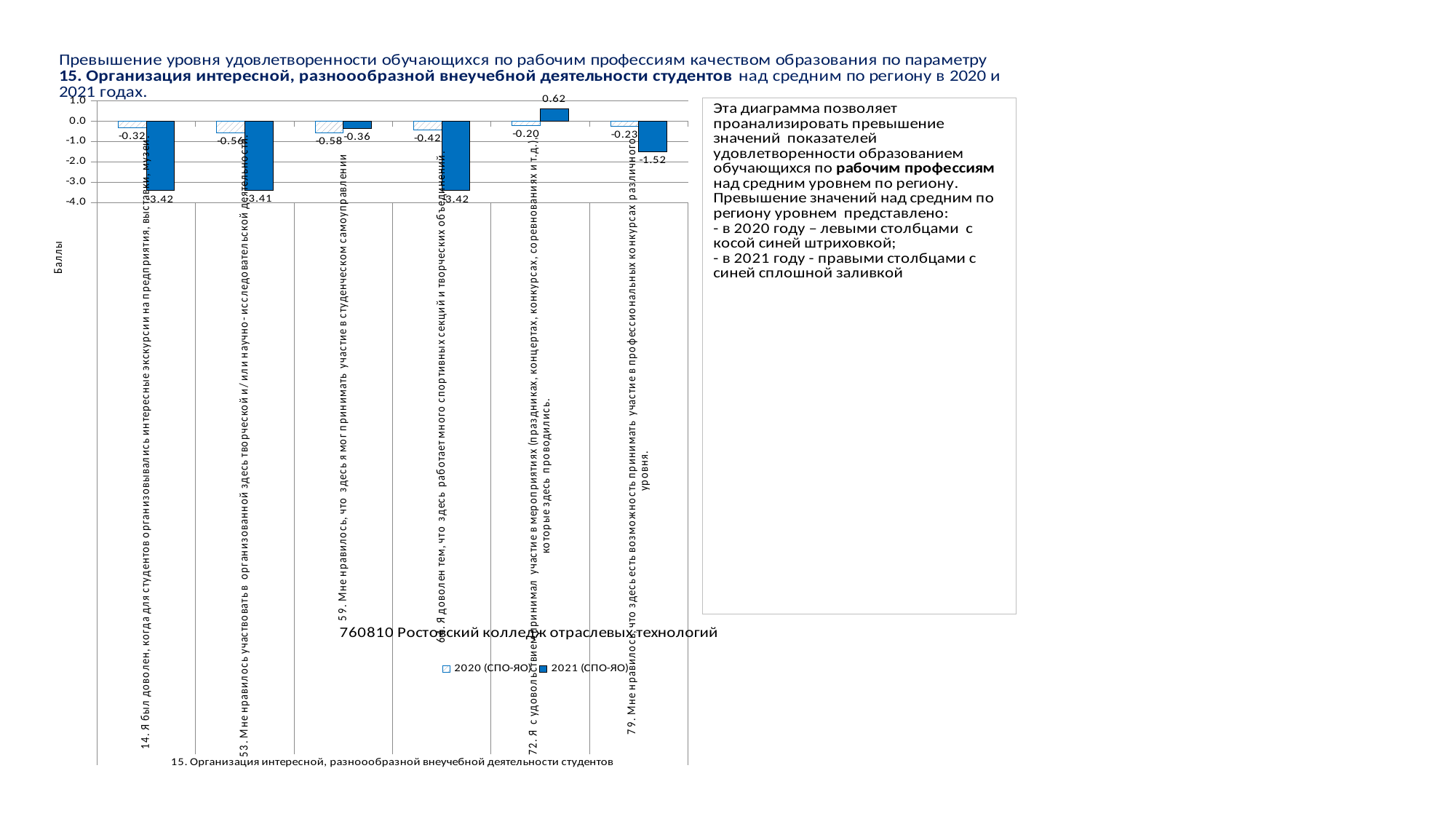
Which category has the lowest 2020 (СПО-ЯО) value? 59. Мне нравилось, что здесь я мог принимать участие в студенческом самоуправлении How many categories are shown on the x axis of the chart? 6 Which category has the highest 2021 (СПО-ЯО) value? 72. Я с удовольствием принимал участие в мероприятиях Which is larger: the 2021 (СПО-ЯО) value for category 59 or for category 79? Category 59 What is the difference between the 2021 and 2020 values for category 72? 0.82 How many series does the legend list? 2 Is the 2021 (СПО-ЯО) value for category 14 greater or less than -3.0? less What is the 2021 (СПО-ЯО) value for category 79 (Мне нравилось, что здесь есть возможность принимать участие в профессиональных конкурсах)? -1.52 What is the 2021 (СПО-ЯО) value for category 72 (Я с удовольствием принимал участие в мероприятиях)? 0.62 What type of chart is shown on the slide? Bar chart What is the 2020 (СПО-ЯО) value for category 14 (Я был доволен, когда для студентов организовывались интересные экскурсии)? -0.32